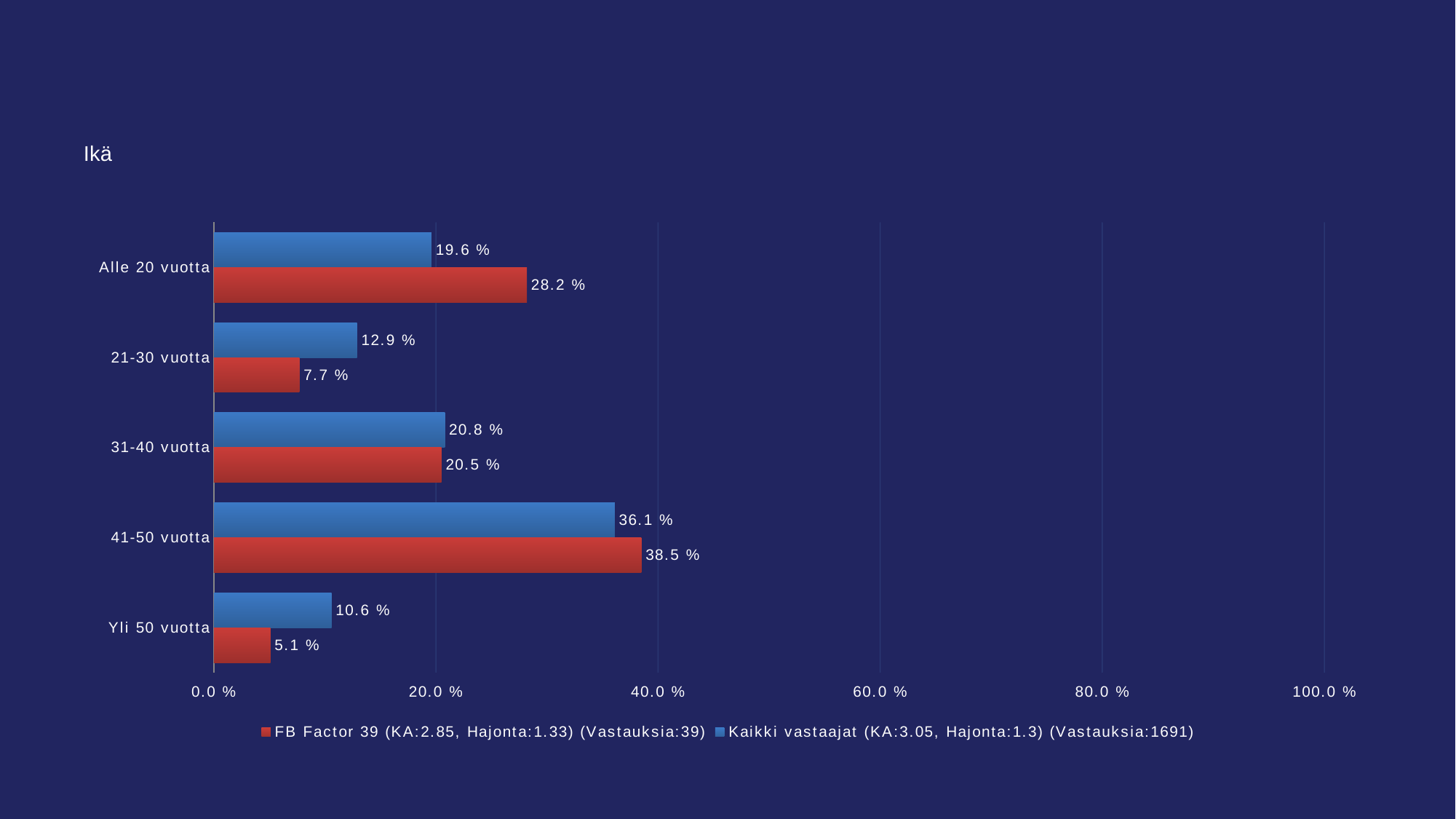
What is the difference between the 'Kaikki vastaajat' and 'FB Factor 39' values for 'Yli 50 vuotta'? 5.5 % For '21-30 vuotta', which series has the larger value, 'FB Factor 39' or 'Kaikki vastaajat'? Kaikki vastaajat Which age category has the highest value in the 'Kaikki vastaajat' series? 41-50 vuotta What kind of chart is shown on the slide? bar chart What is the value for 'Alle 20 vuotta' in the 'FB Factor 39' series? 28.2 % What is the value for 'Yli 50 vuotta' in the 'FB Factor 39' series? 5.1 % Is the 'FB Factor 39' value for '41-50 vuotta' greater or less than 40.0 %? less What is the value for '41-50 vuotta' in the 'Kaikki vastaajat' series? 36.1 % How many series does the legend list? 2 What is the difference between the 'FB Factor 39' and 'Kaikki vastaajat' values for 'Alle 20 vuotta'? 8.6 % How many age categories are shown on the chart? 5 Which age category has the lowest value in the 'FB Factor 39' series? Yli 50 vuotta